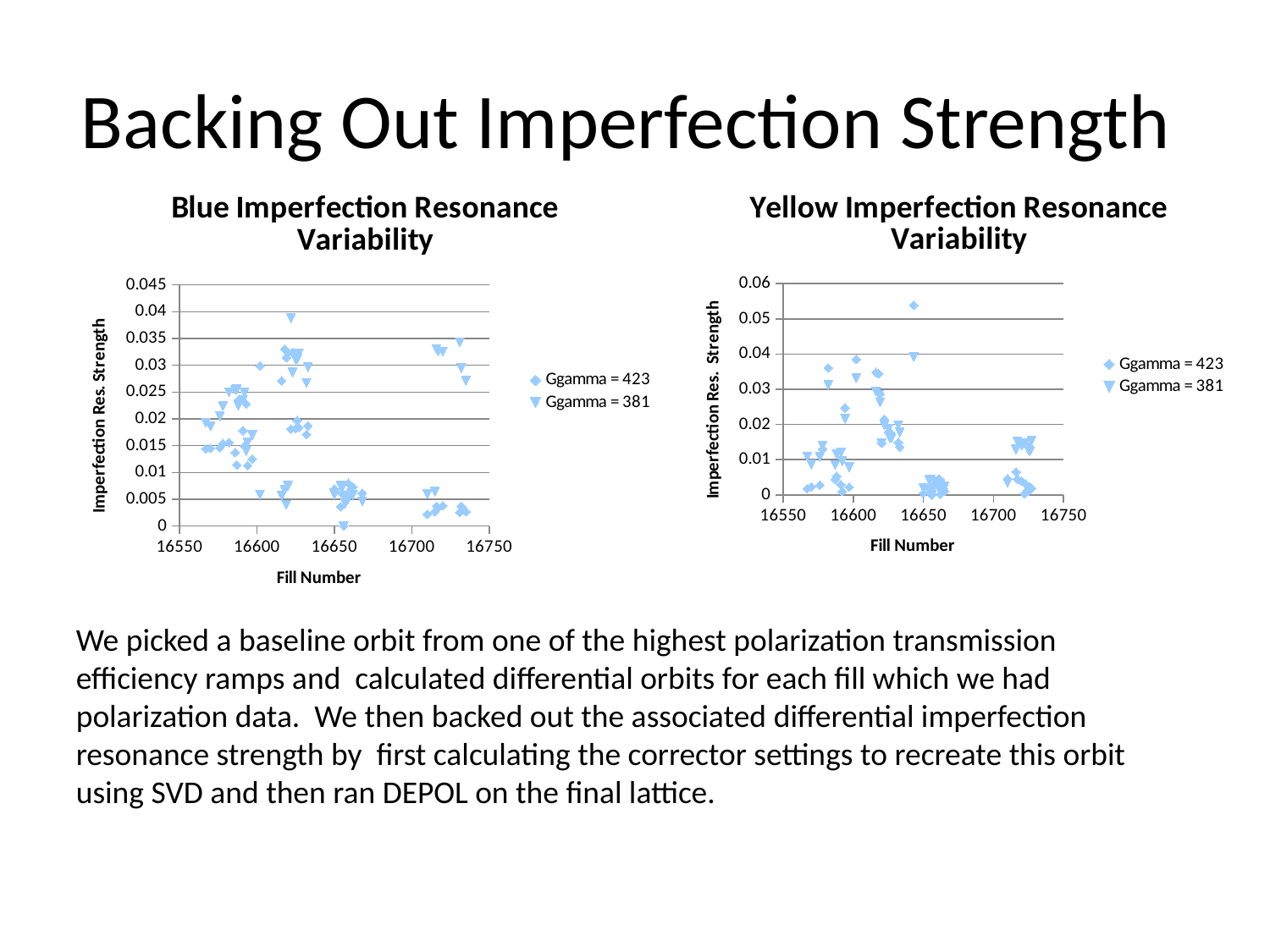
In the "Blue Imperfection Resonance Variability" chart, is the highest plotted point greater or less than 0.035? greater In the "Blue Imperfection Resonance Variability" chart, are the Ggamma = 423 points clustered near fill number 16650 greater or less than 0.01? less What kind of chart is the "Yellow Imperfection Resonance Variability" chart? Scatter chart What is the x-axis title of the "Blue Imperfection Resonance Variability" chart? Fill Number In the "Yellow Imperfection Resonance Variability" chart, are the points clustered near fill number 16650 greater or less than 0.01? less How many series does the legend of the "Blue Imperfection Resonance Variability" chart list? 2 What kind of chart is the "Blue Imperfection Resonance Variability" chart? Scatter chart In the "Yellow Imperfection Resonance Variability" chart, what are the two series named in the legend? Ggamma = 423 and Ggamma = 381 How many series does the legend of the "Yellow Imperfection Resonance Variability" chart list? 2 Which chart has the higher maximum value on its y-axis, the Blue chart or the Yellow chart? Yellow Imperfection Resonance Variability